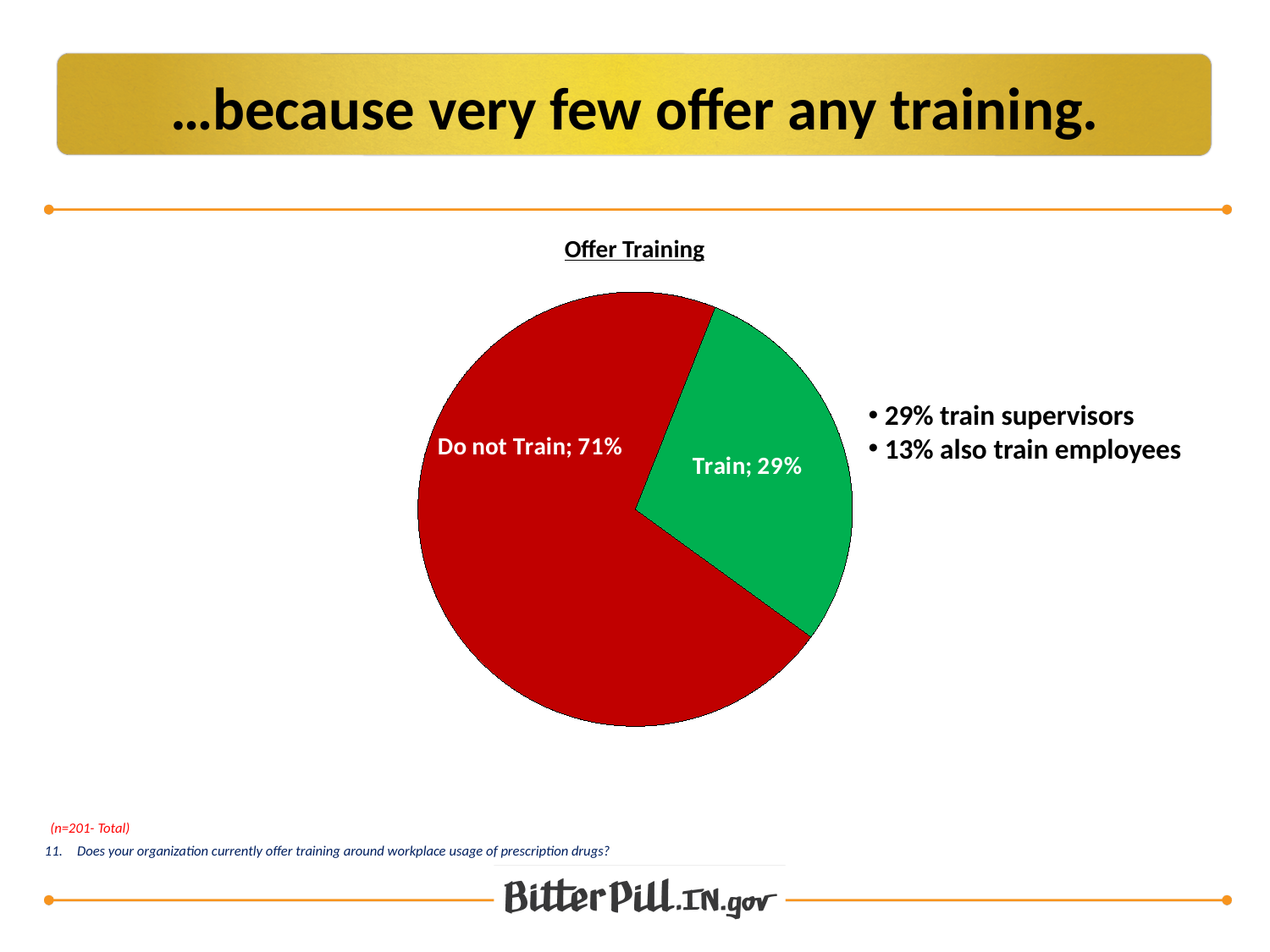
What colour is the 'Do not Train' slice? Red What type of chart is shown on the slide? Pie chart How many slices does the pie chart have? 2 What percentage of organizations offer training according to the pie chart? 29% Which is larger: the 'Train' slice or the 'Do not Train' slice? Do not Train What is the title of the chart? Offer Training Which slice of the pie chart is the largest? Do not Train What is the difference in percentage points between the 'Do not Train' and 'Train' slices? 42 What share of the pie does the 'Train' slice represent? 29% Which slice of the pie chart is the smallest? Train What percentage of organizations do not offer training according to the pie chart? 71%